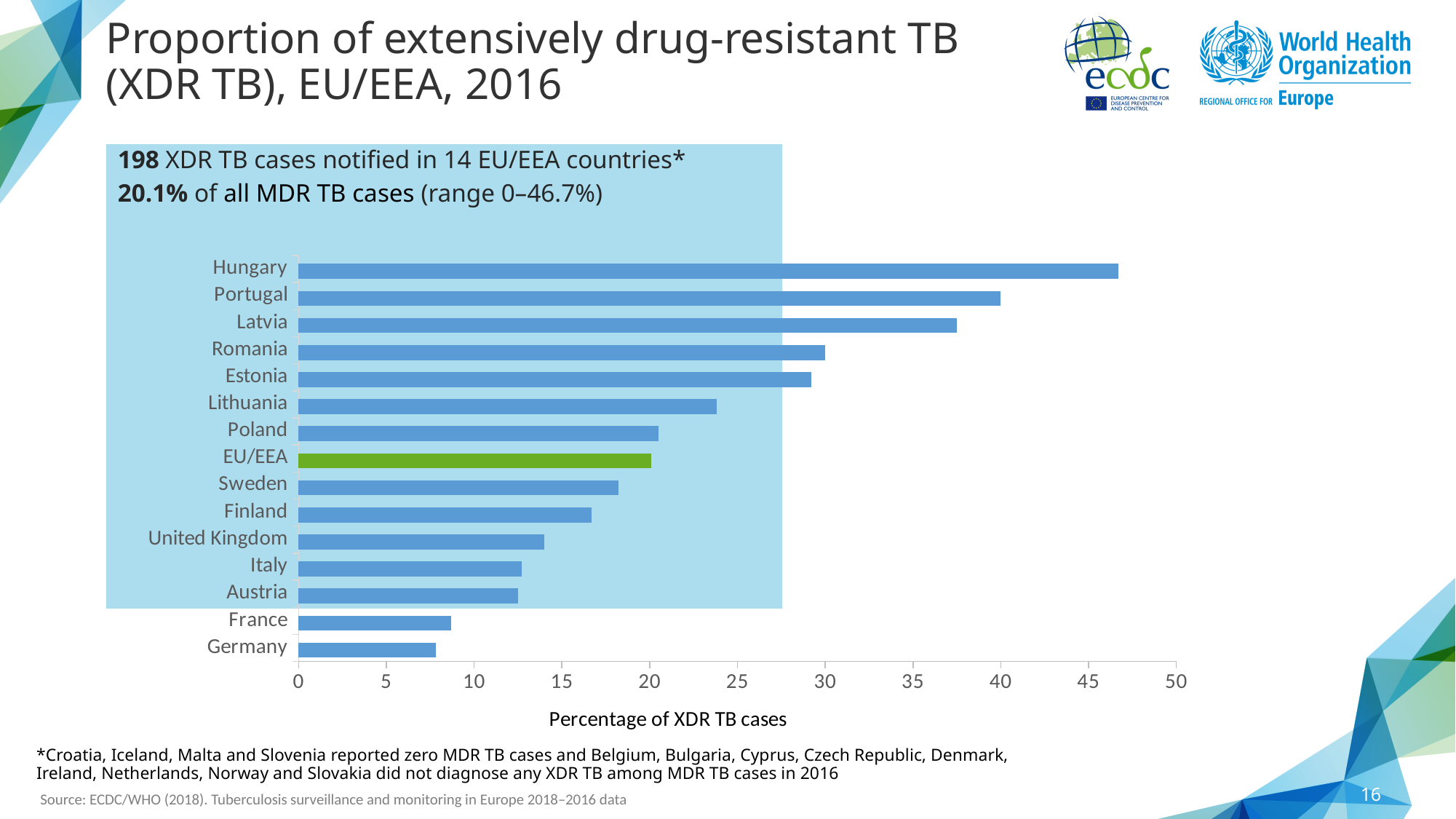
Which category has the lowest percentage of XDR TB cases? Germany Which bar in the chart is coloured green rather than blue? EU/EEA Which has a higher percentage of XDR TB cases, Latvia or Romania? Latvia How many bars (categories) are plotted in the chart? 15 Which category has the highest percentage of XDR TB cases? Hungary What kind of chart is shown on the slide? bar chart Is the value for Latvia greater or less than 35? greater Is the value for Estonia greater or less than 30? less What is the percentage of XDR TB cases for EU/EEA? 20.1% Is the value for France greater or less than 10? less What is the label of the horizontal axis? Percentage of XDR TB cases